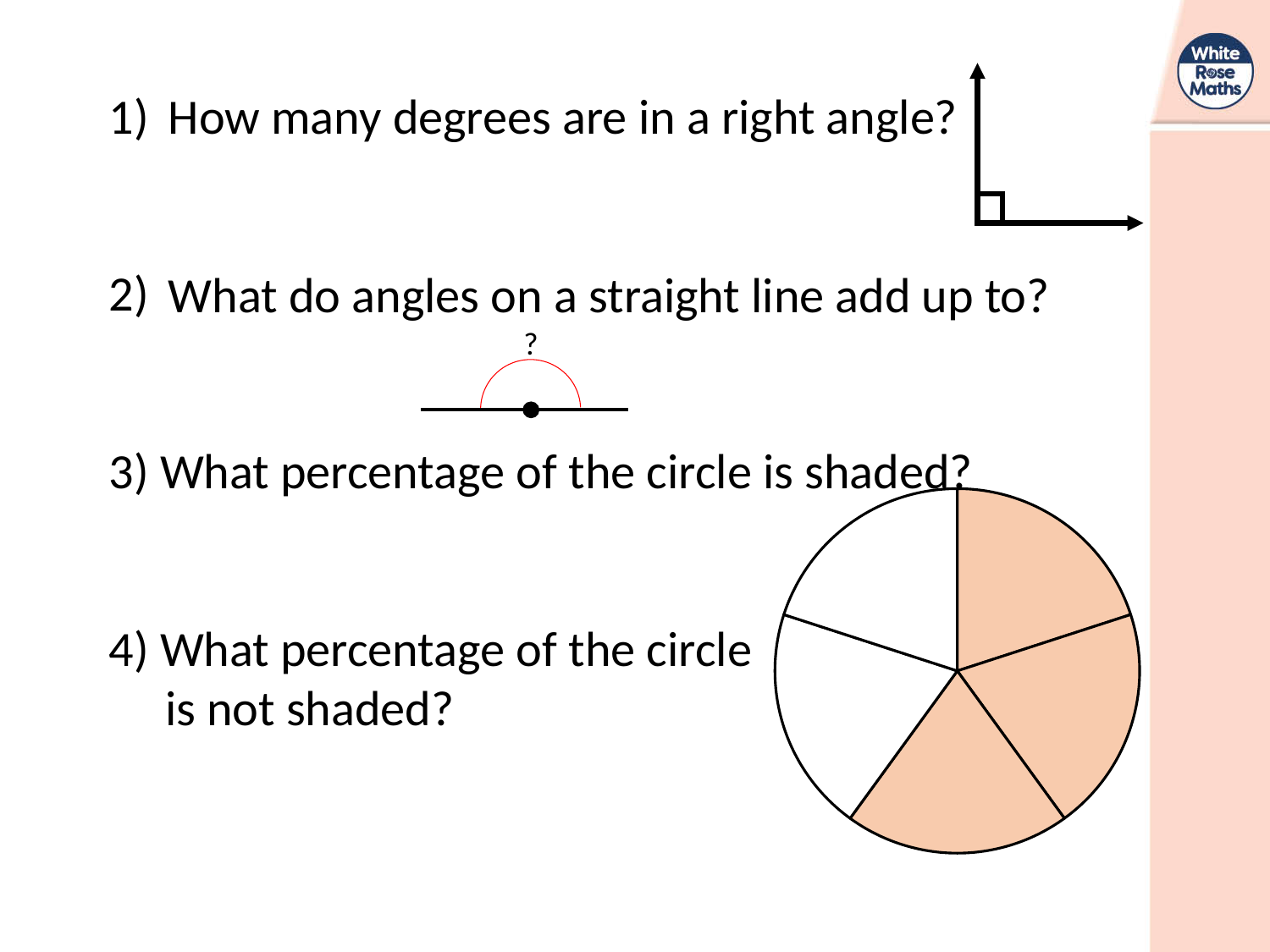
What colour are the shaded slices of the pie chart? orange Which is larger in the pie chart, the shaded part or the unshaded part? the shaded part How many slices of the pie chart are shaded? 3 Is more or less than half of the pie chart shaded? more How many slices of the pie chart are not shaded? 2 How many slices is the pie chart divided into? 5 What kind of chart is shown on the slide? pie chart Does the pie chart have a legend? no